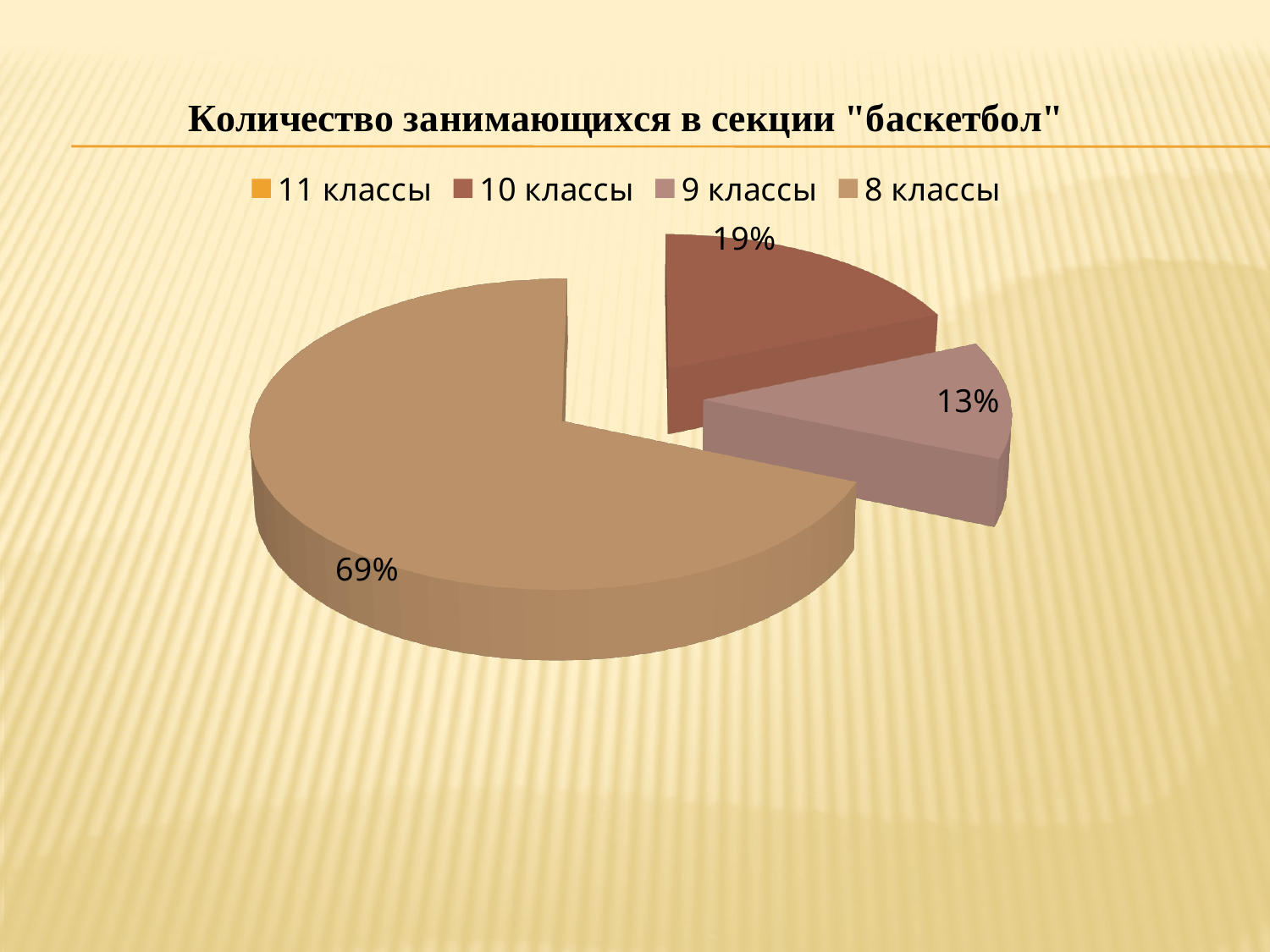
What is the title of the chart? Количество занимающихся в секции "баскетбол" What percentage of the pie is taken by 9 классы? 13% How many slices of the pie have a percentage label? 3 How many categories does the legend list? 4 Which slice is larger, 10 классы or 9 классы? 10 классы What percentage of the pie is taken by 8 классы? 69% What is the difference in percentage points between the 8 классы slice and the 10 классы slice? 50 Which category has the largest slice of the pie? 8 классы What is the difference in percentage points between the 10 классы slice and the 9 классы slice? 6 What type of chart is shown on the slide? Pie chart Which of the labelled slices is the smallest? 9 классы What percentage of the pie is taken by 10 классы? 19%